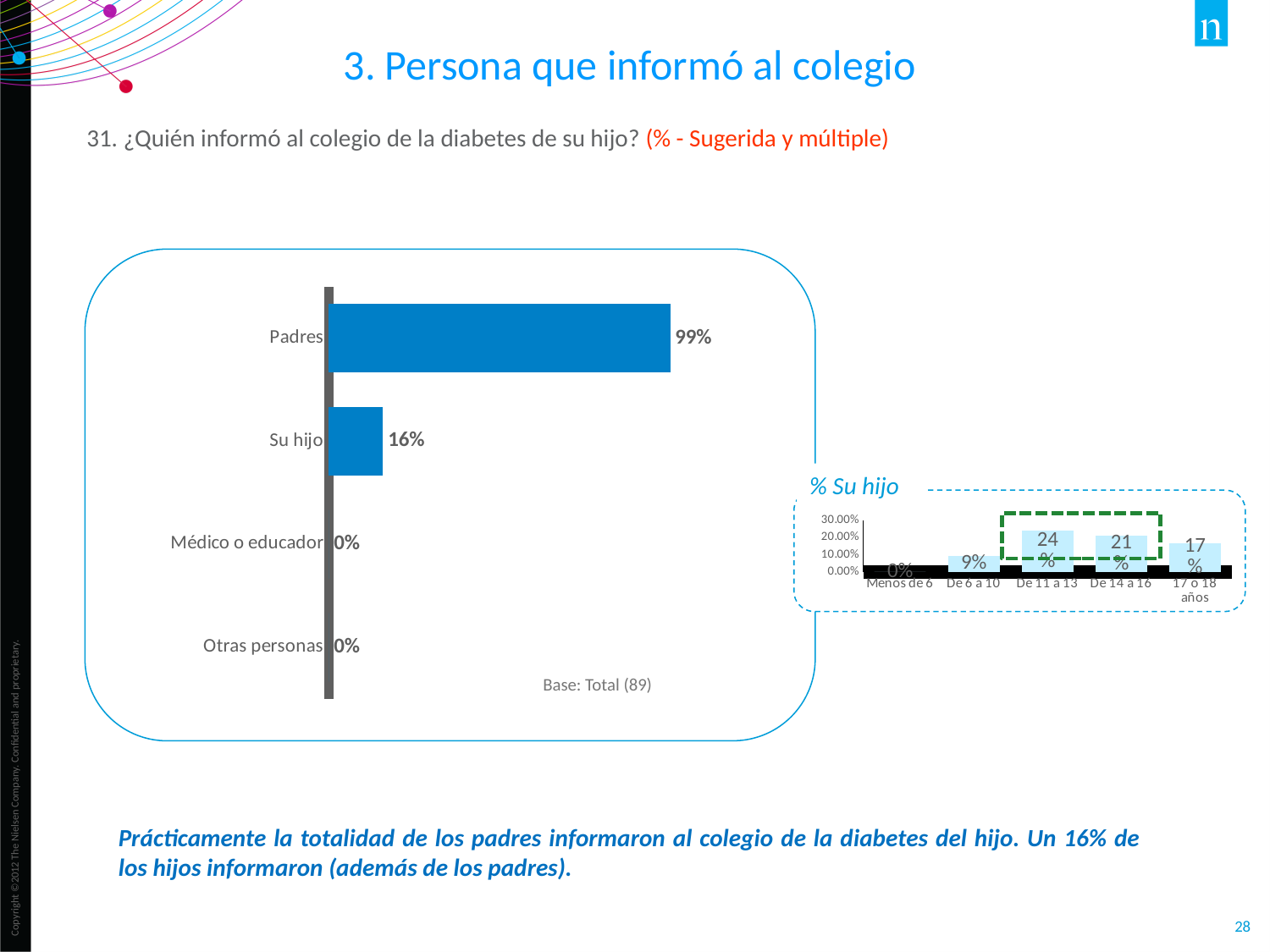
In the main bar chart, what is the value for Padres? 99% In the main bar chart, what is the difference between the values for Padres and Su hijo? 83% In the '% Su hijo' chart, what is the value for De 11 a 13? 24% In the main bar chart, how many categories are shown? 4 In the '% Su hijo' chart, what is the value for De 6 a 10? 9% In the '% Su hijo' chart, which age group has the highest value? De 11 a 13 In the main bar chart, which category has the highest value? Padres In the '% Su hijo' chart, how many age groups are shown? 5 What kind of chart is the main chart on the left? Bar chart In the '% Su hijo' chart, which is larger: the value for De 14 a 16 or for 17 o 18 años? De 14 a 16 In the main bar chart, what is the value for Su hijo? 16% In the main bar chart, what is the value for Médico o educador? 0%